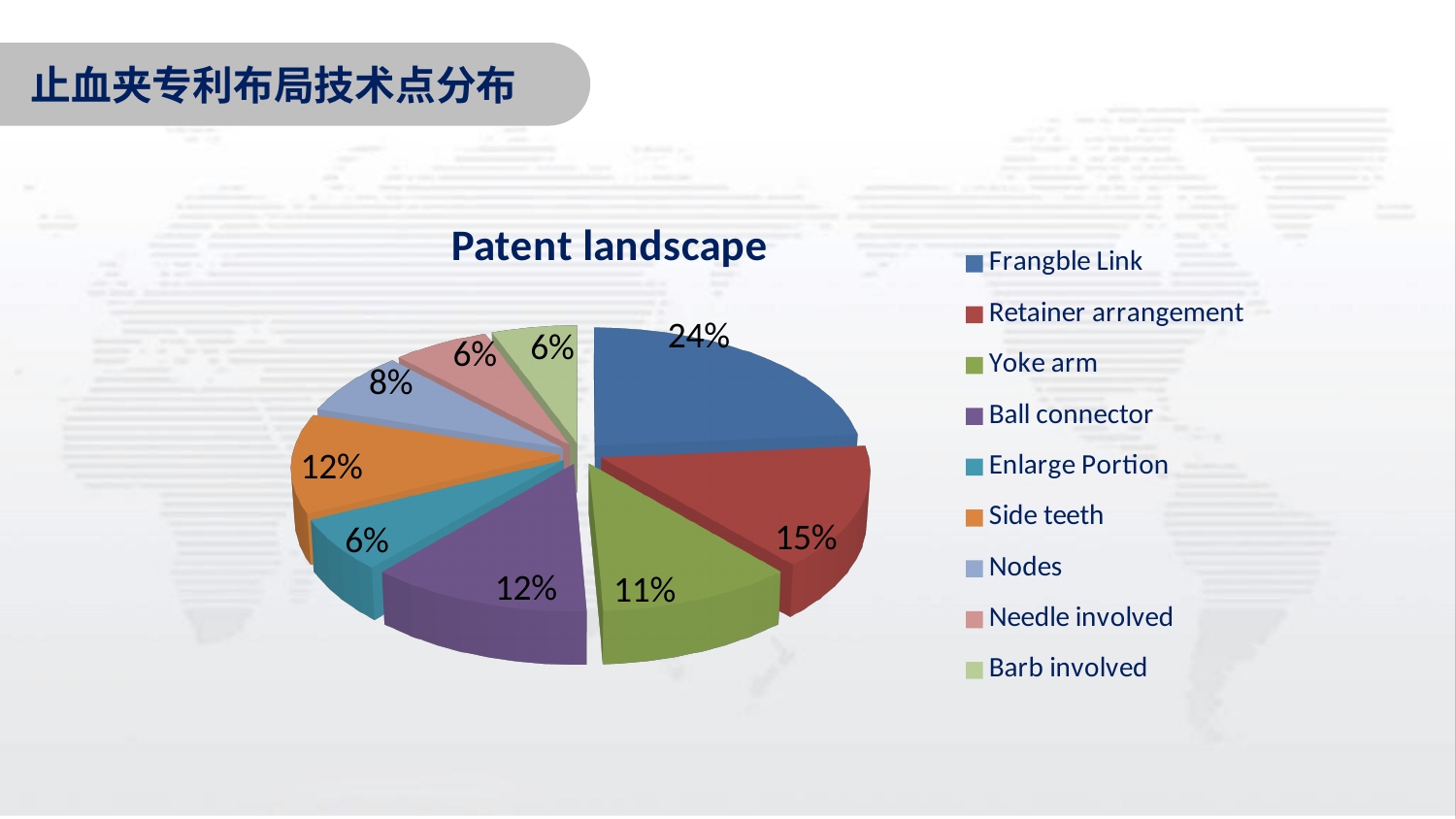
How many categories does the legend of the pie chart list? 9 Which category has the largest share of the pie? Frangble Link What is the title of the chart? Patent landscape Which is larger, the share for Ball connector or the share for Nodes? Ball connector What share of the pie does Side teeth have? 12% What kind of chart is shown on the slide? pie chart What share of the pie does Yoke arm have? 11% What share of the pie does Frangble Link have? 24% Which colour represents Side teeth in the pie chart? orange What is the difference in percentage points between Frangble Link and Retainer arrangement? 9